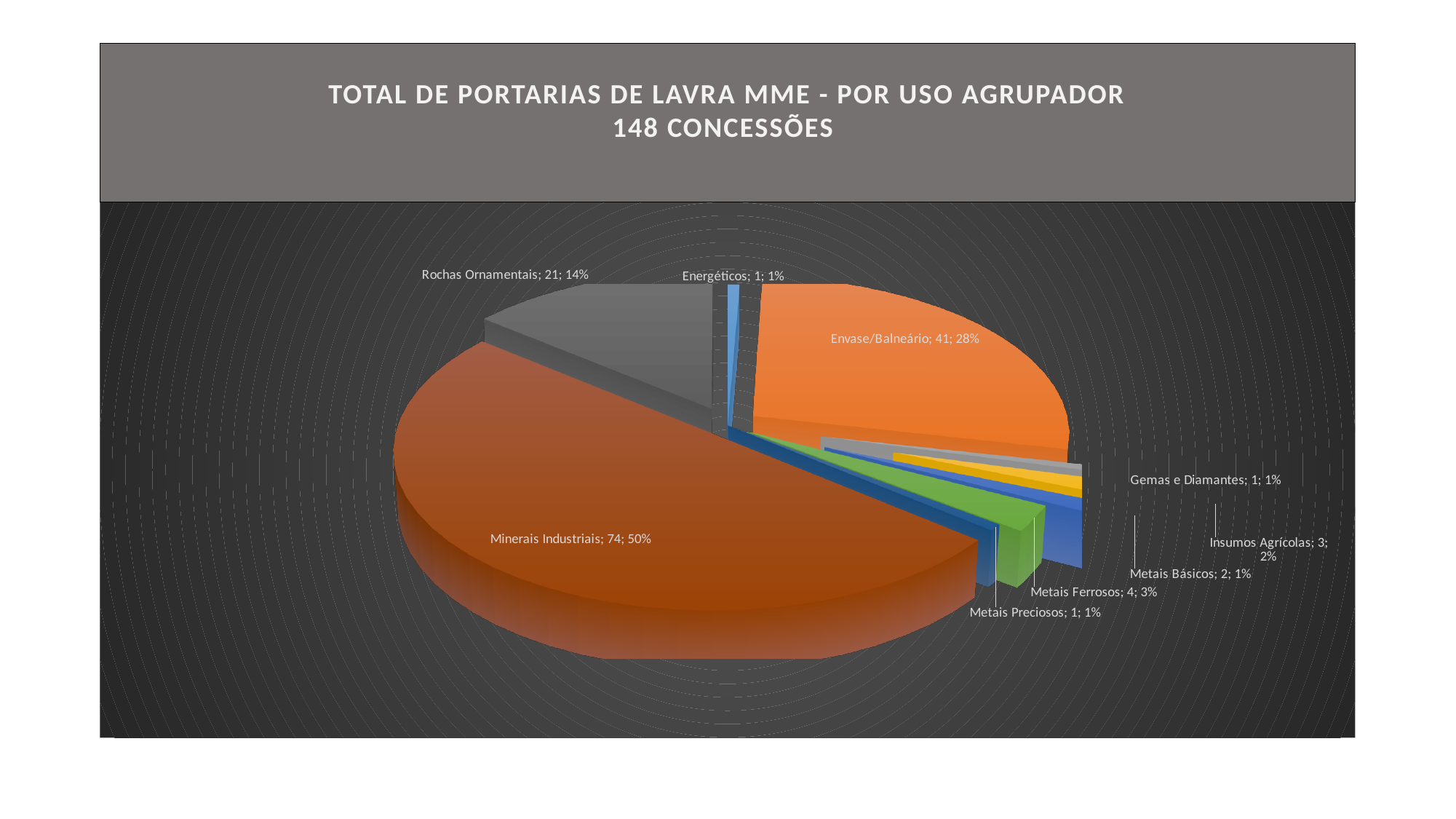
Which has more concessions, Metais Ferrosos or Insumos Agrícolas? Metais Ferrosos What share of the pie does Metais Ferrosos represent? 3% What kind of chart is shown on the slide? pie chart What is the difference in concessions between Rochas Ornamentais and Metais Ferrosos? 17 How many concessions are shown for Minerais Industriais? 74 How many categories are shown in the pie chart? 9 What share of the pie does Envase/Balneário represent? 28% What is the total number of concessions stated in the chart title? 148 How many concessions are shown for Metais Básicos? 2 Which category has the largest slice of the pie? Minerais Industriais What is the difference in concessions between Minerais Industriais and Envase/Balneário? 33 How many concessions are shown for Rochas Ornamentais? 21